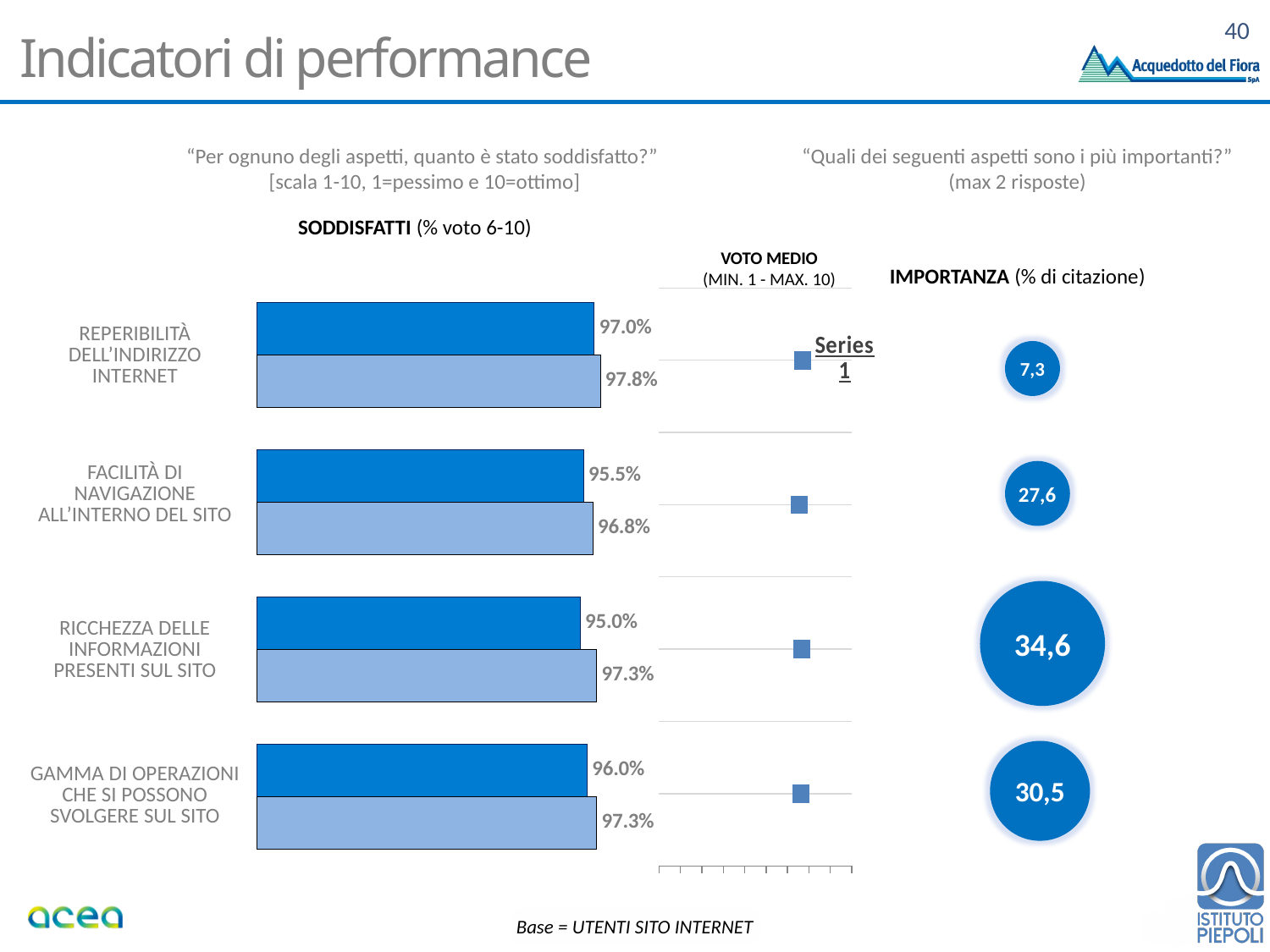
In the SODDISFATTI bar chart, which category has the highest value on its light blue bar? REPERIBILITÀ DELL'INDIRIZZO INTERNET What kind of chart is the SODDISFATTI chart? bar chart In the SODDISFATTI bar chart, what value is printed on the light blue bar for FACILITÀ DI NAVIGAZIONE ALL'INTERNO DEL SITO? 96.8% In the IMPORTANZA (% di citazione) chart, which category has the lowest value? REPERIBILITÀ DELL'INDIRIZZO INTERNET In the SODDISFATTI bar chart, which category has the lowest value on its dark blue bar? RICCHEZZA DELLE INFORMAZIONI PRESENTI SUL SITO In the IMPORTANZA (% di citazione) chart, what is the value for FACILITÀ DI NAVIGAZIONE ALL'INTERNO DEL SITO? 27,6 In the SODDISFATTI bar chart, what value is printed on the dark blue bar for GAMMA DI OPERAZIONI CHE SI POSSONO SVOLGERE SUL SITO? 96.0% In the SODDISFATTI bar chart, what is the difference between the light blue bar and the dark blue bar for REPERIBILITÀ DELL'INDIRIZZO INTERNET? 0.8% In the SODDISFATTI bar chart, how many categories are shown? 4 In the SODDISFATTI bar chart, what value is printed on the dark blue bar for REPERIBILITÀ DELL'INDIRIZZO INTERNET? 97.0% In the IMPORTANZA (% di citazione) chart, which category has the highest value? RICCHEZZA DELLE INFORMAZIONI PRESENTI SUL SITO